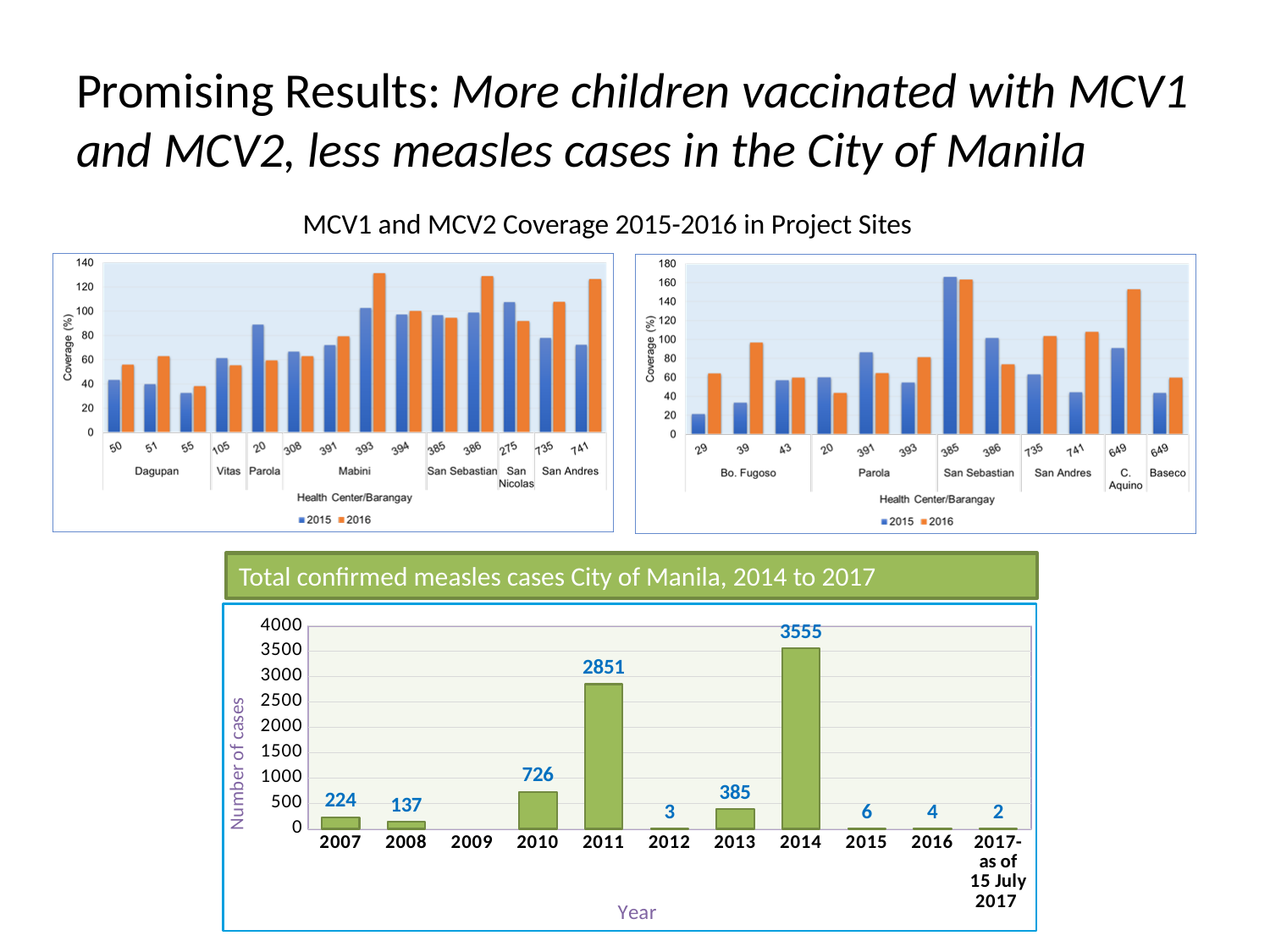
What type of chart is the bottom chart of measles cases? Bar chart In the bottom chart 'Total confirmed measles cases City of Manila, 2014 to 2017', how many confirmed measles cases were there in 2014? 3555 In the bottom chart of measles cases, which is larger, the value for 2007 or the value for 2008? 2007 In the top-left coverage chart, how many series does the legend list? 2 In the bottom chart of measles cases, what is the value shown for 2017 (as of 15 July 2017)? 2 In the bottom chart of measles cases, what is the difference between the 2010 and 2013 values? 341 In the bottom chart of measles cases, which year has the highest number of cases? 2014 In the bottom chart of measles cases, what is the difference between the 2014 and 2011 values? 704 In the top-left coverage chart, is the 2016 value for Mabini barangay 393 greater or less than 120? greater In the top-right coverage chart, is the 2015 value for San Sebastian barangay 385 greater or less than 140? greater In the bottom chart of measles cases, what is the value for 2011? 2851 In the bottom chart of measles cases, how many years are labelled on the x axis? 11